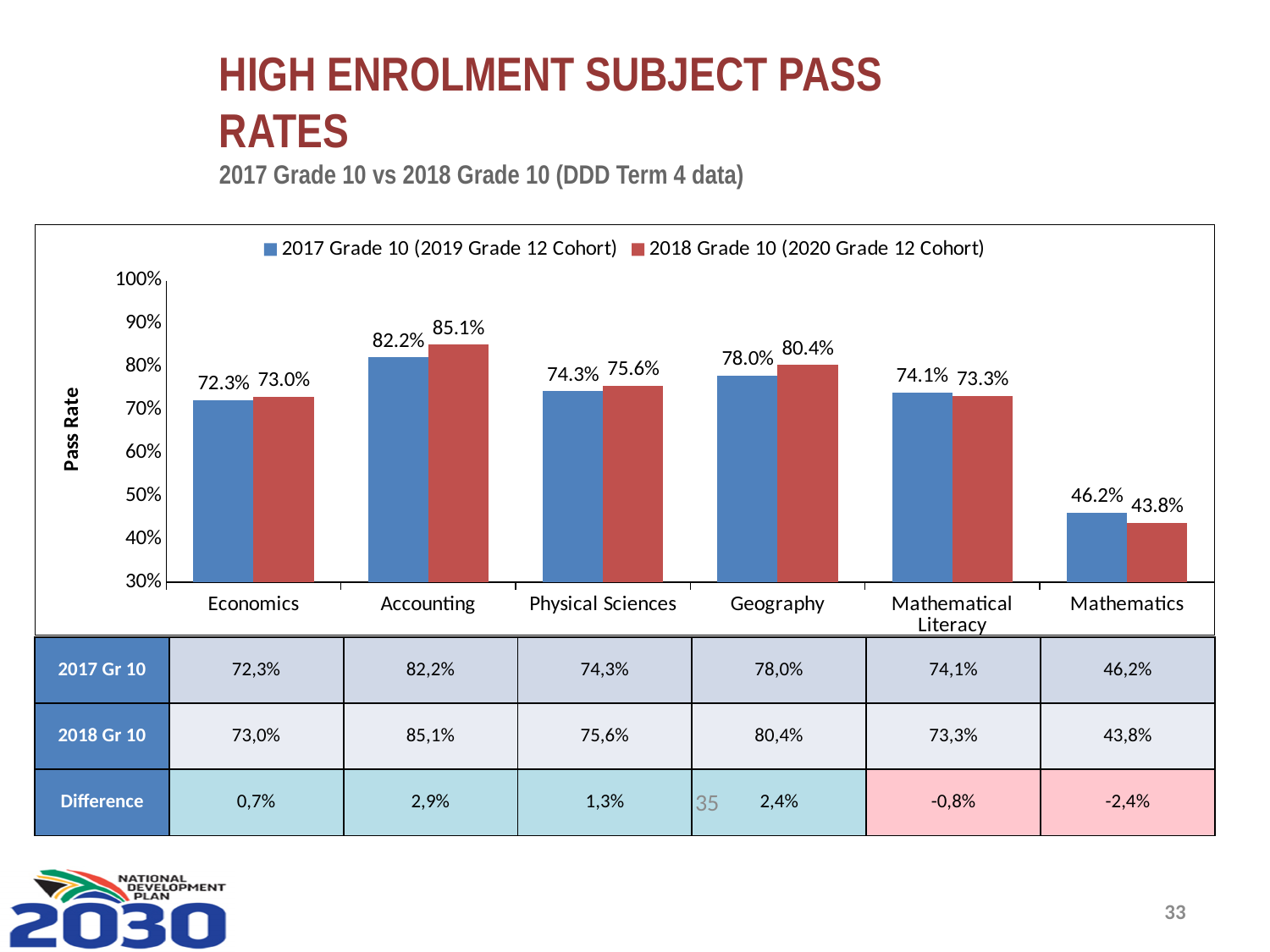
What is the difference between the 2018 Grade 10 and 2017 Grade 10 pass rates for Accounting? 2.9% Which subject has the highest pass rate in the 2017 Grade 10 (2019 Grade 12 Cohort) series? Accounting What is the pass rate for Accounting in the 2018 Grade 10 (2020 Grade 12 Cohort) series? 85.1% For Mathematical Literacy, which series has the higher pass rate: 2017 Grade 10 or 2018 Grade 10? 2017 Grade 10 What is the pass rate for Geography in the 2018 Grade 10 (2020 Grade 12 Cohort) series? 80.4% Is the 2018 Grade 10 pass rate for Mathematics greater or less than 50%? less What type of chart is shown on the slide? Bar chart How many series does the chart legend list? 2 What is the pass rate for Mathematics in the 2017 Grade 10 (2019 Grade 12 Cohort) series? 46.2% How many subjects are shown on the x axis of the chart? 6 What is the difference between the 2017 Grade 10 and 2018 Grade 10 pass rates for Mathematics? 2.4% Which subject has the lowest pass rate in the 2018 Grade 10 (2020 Grade 12 Cohort) series? Mathematics